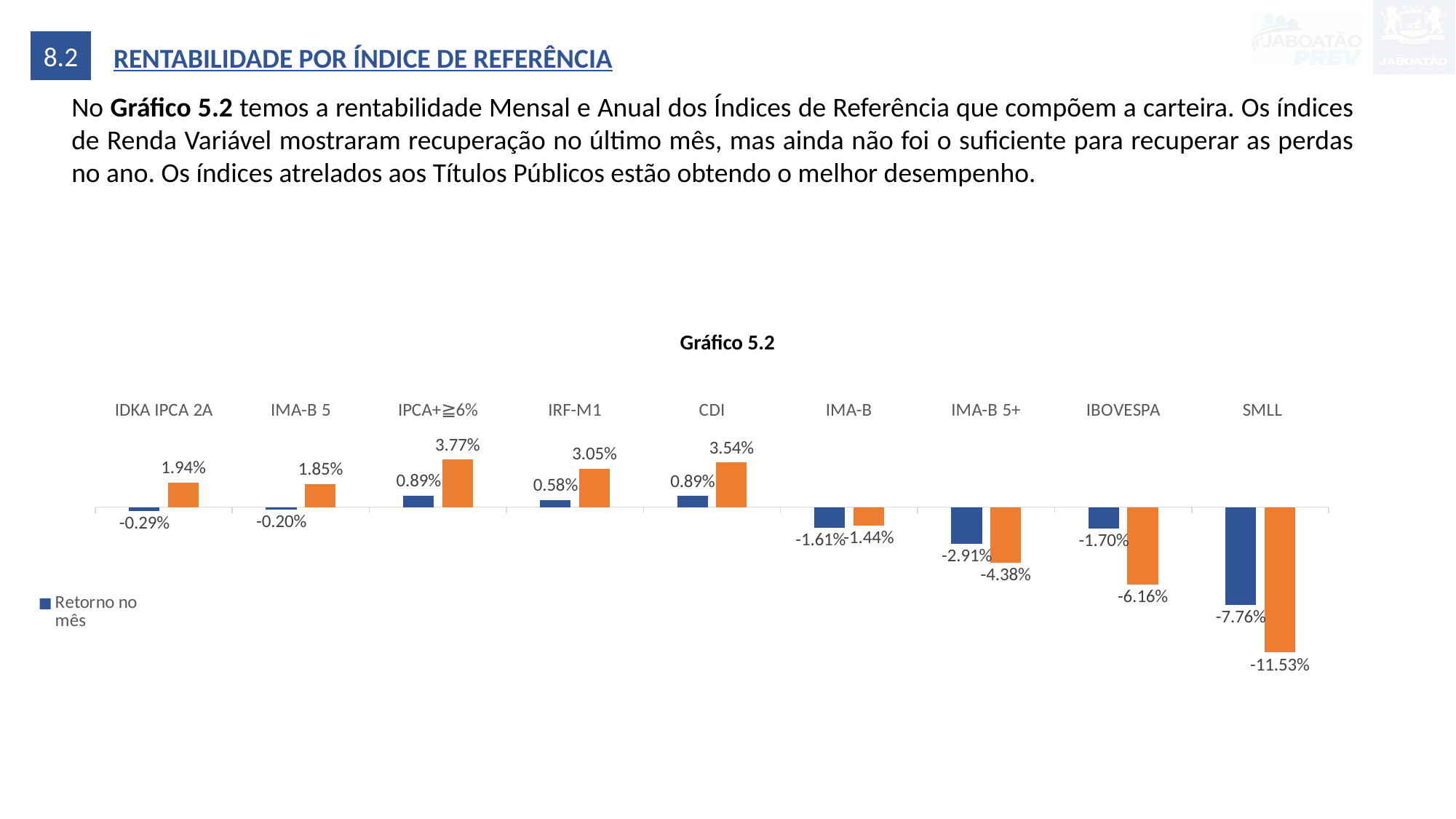
In Gráfico 5.2, what is the value of the orange bar for CDI? 3.54% In Gráfico 5.2, what is the value of the blue 'Retorno no mês' bar for IBOVESPA? -1.70% How many indices (categories) are shown in Gráfico 5.2? 9 In Gráfico 5.2, what is the lowest value shown among the orange bars? -11.53% In Gráfico 5.2, what is the value of the orange bar for IMA-B 5? 1.85% What is the legend entry shown for the blue series in Gráfico 5.2? Retorno no mês In Gráfico 5.2, which has the larger orange bar value, IRF-M1 or CDI? CDI In Gráfico 5.2, what is the 'Retorno no mês' value for IRF-M1? 0.58% In Gráfico 5.2, which index has the lowest 'Retorno no mês' value? SMLL In Gráfico 5.2, which index has the highest orange bar value? IPCA+≧6% In Gráfico 5.2, what is the difference between the orange bar value and the 'Retorno no mês' value for IBOVESPA? 4.46 percentage points What type of chart is Gráfico 5.2? Bar chart